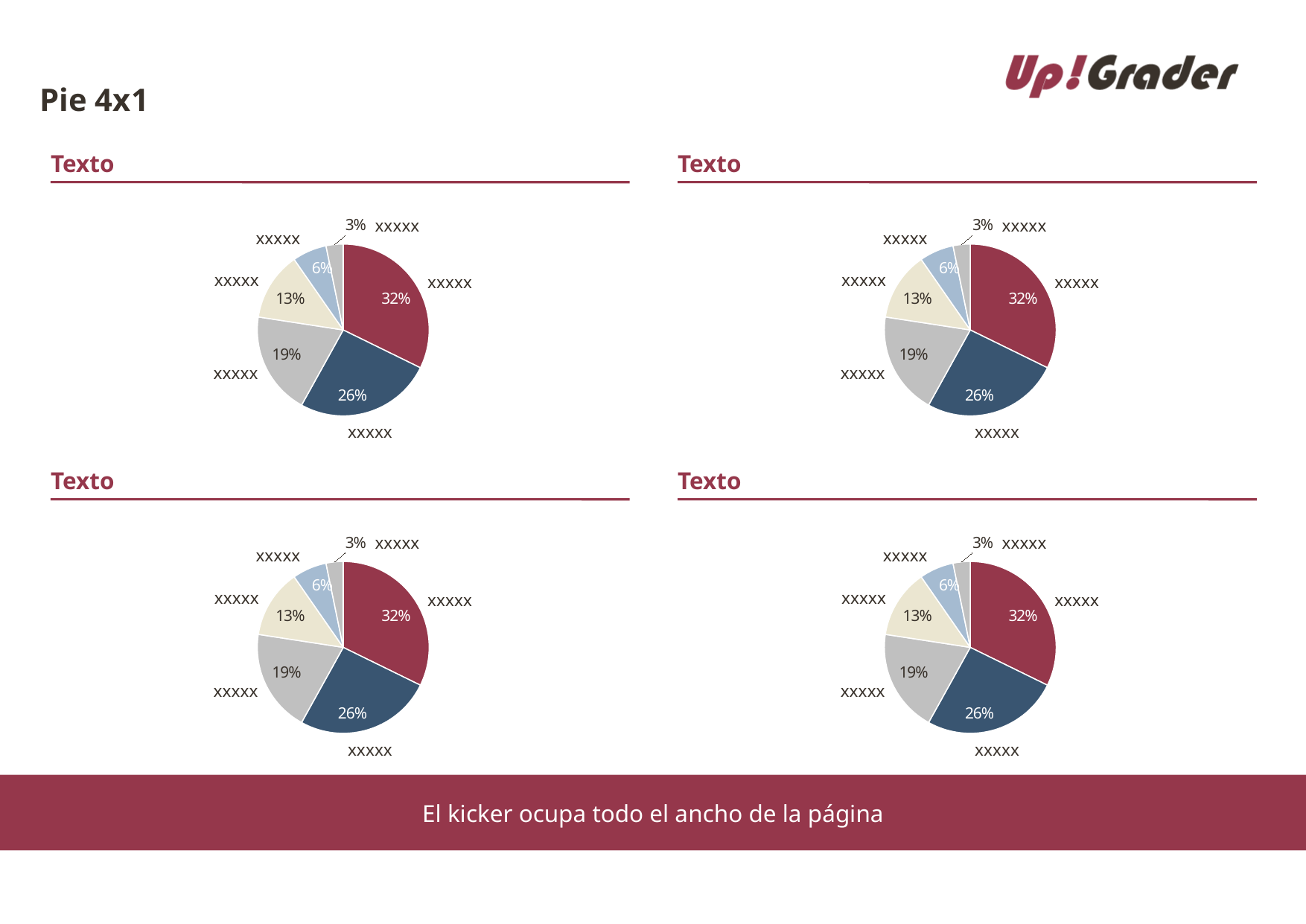
In the top-right pie chart, what is the value of the smallest slice? 3% In the top-left pie chart, what is the value of the largest slice? 32% In the top-right pie chart, what percentage is shown on the beige slice? 13% What kind of chart is the top-left chart on the slide? Pie chart In the bottom-left pie chart, what is the difference between the dark red slice (32%) and the dark blue slice (26%)? 6 percentage points In the top-left pie chart, what percentage is shown on the grey slice? 19% In the top-left pie chart, how many slices does the pie have? 6 In the bottom-left pie chart, what percentage is shown on the dark red slice? 32% How many charts are shown on the slide? 4 In the bottom-right pie chart, what percentage is shown on the dark blue slice? 26% What is the heading text shown above each of the four pie charts? Texto In the bottom-right pie chart, which slice is larger, the dark blue slice or the grey slice? The dark blue slice